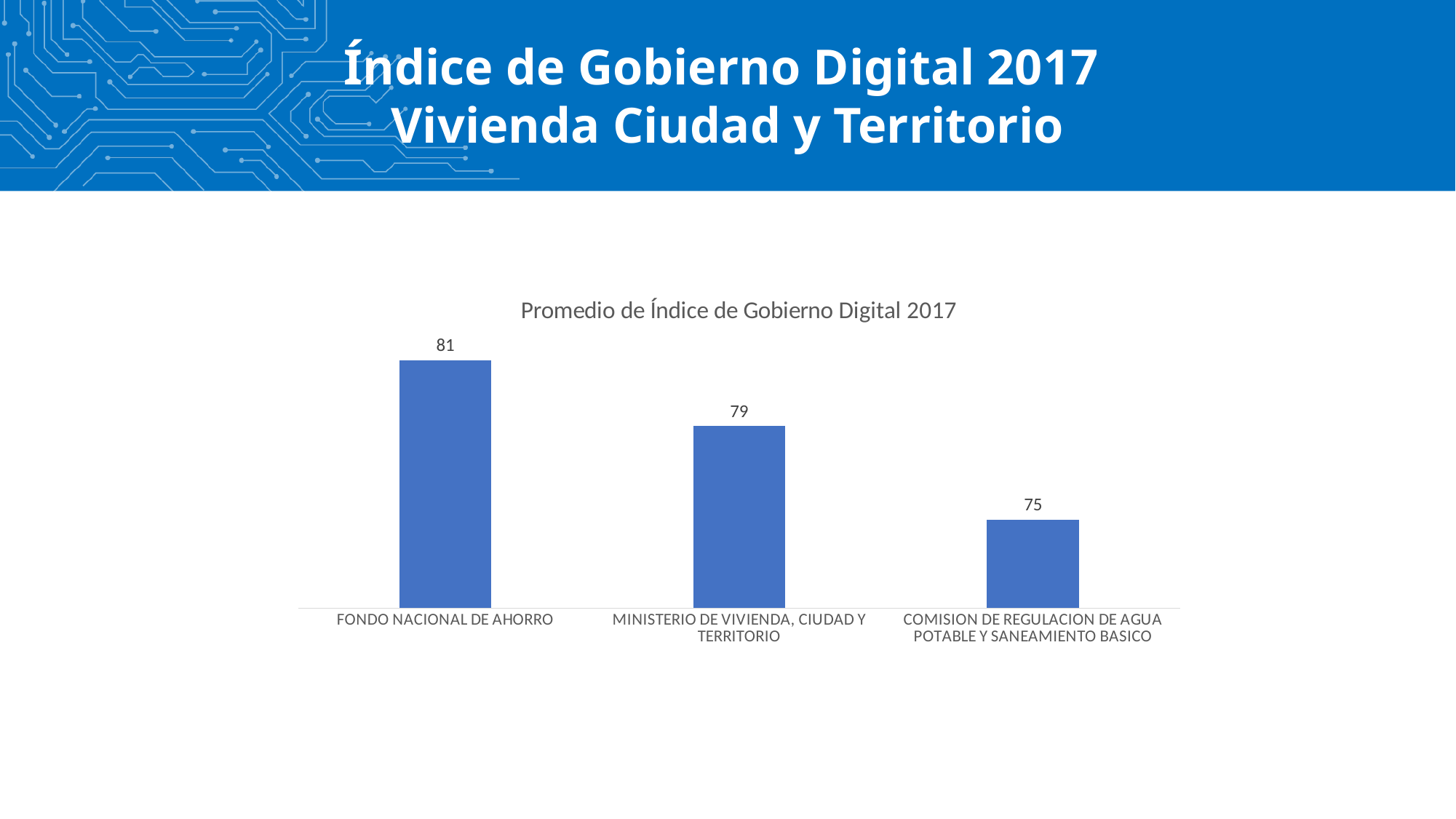
Which is larger, the value for MINISTERIO DE VIVIENDA, CIUDAD Y TERRITORIO or the value for COMISION DE REGULACION DE AGUA POTABLE Y SANEAMIENTO BASICO? MINISTERIO DE VIVIENDA, CIUDAD Y TERRITORIO Which category has the highest value? FONDO NACIONAL DE AHORRO What is the title of the chart? Promedio de Índice de Gobierno Digital 2017 What is the value for COMISION DE REGULACION DE AGUA POTABLE Y SANEAMIENTO BASICO? 75 What is the value for MINISTERIO DE VIVIENDA, CIUDAD Y TERRITORIO? 79 What is the value for FONDO NACIONAL DE AHORRO? 81 What is the difference between the values for FONDO NACIONAL DE AHORRO and MINISTERIO DE VIVIENDA, CIUDAD Y TERRITORIO? 2 What kind of chart is shown on the slide? Bar chart Do the values rise or fall from left to right across the categories? Fall How many categories are shown in the chart? 3 Which category has the lowest value? COMISION DE REGULACION DE AGUA POTABLE Y SANEAMIENTO BASICO What is the difference between the values for FONDO NACIONAL DE AHORRO and COMISION DE REGULACION DE AGUA POTABLE Y SANEAMIENTO BASICO? 6